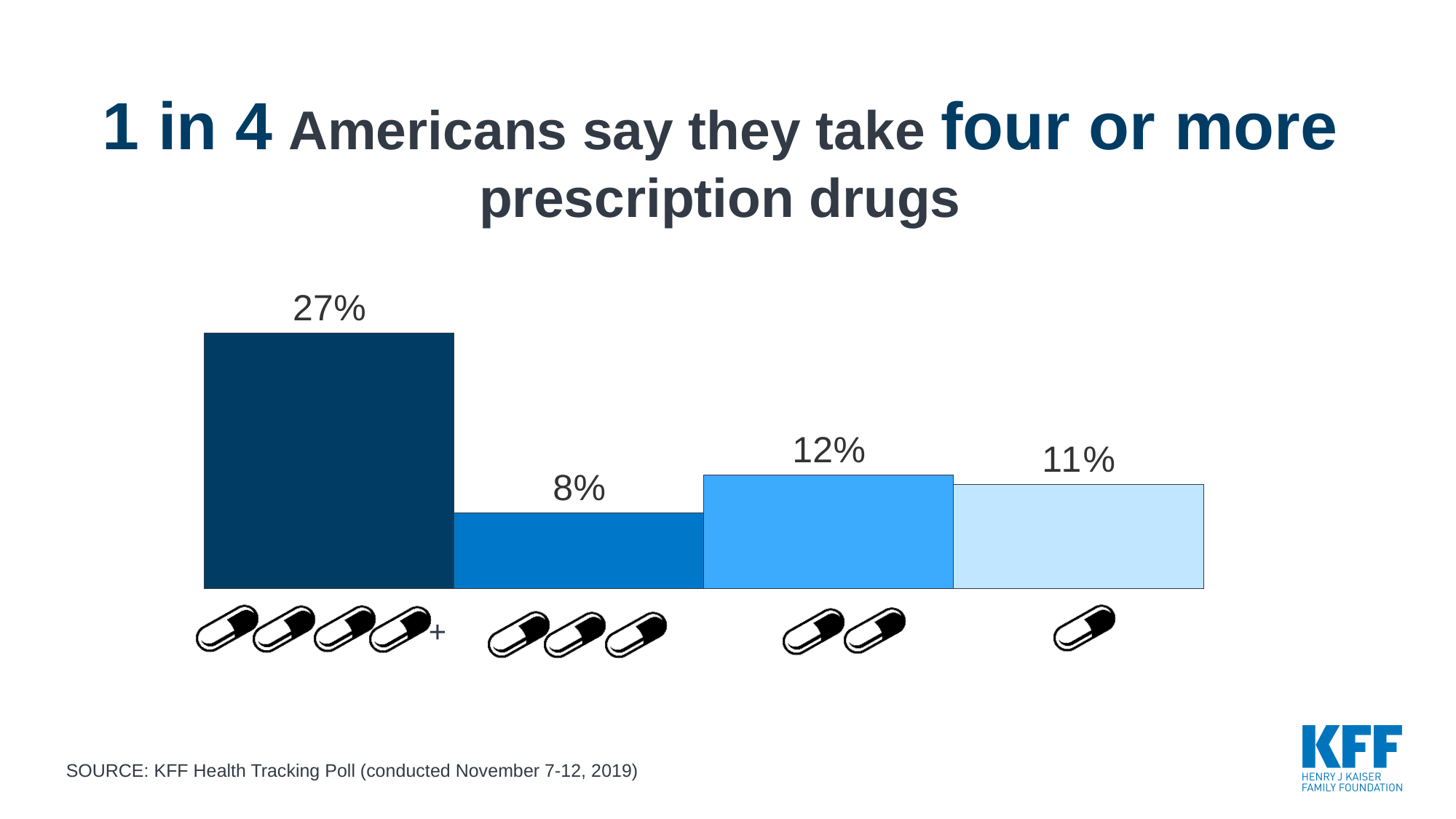
Which bar has the highest value? Four or more pills (27%) What is the value of the bar marked with a single pill icon? 11% What is the value of the bar marked with two pill icons? 12% How many bars are shown in the chart? 4 What is the value of the bar marked with three pill icons? 8% What is the difference between the four-or-more-pills bar and the three-pills bar? 19 percentage points What kind of chart is shown on the slide? Bar chart Which is larger, the value for two pills or the value for three pills? Two pills (12%) What percentage of Americans say they take four or more prescription drugs (the bar marked with four pill icons and a plus sign)? 27% What is the source cited at the bottom of the slide? KFF Health Tracking Poll (conducted November 7-12, 2019) Which bar has the lowest value? Three pills (8%) What is the difference between the two-pills bar and the one-pill bar? 1 percentage point